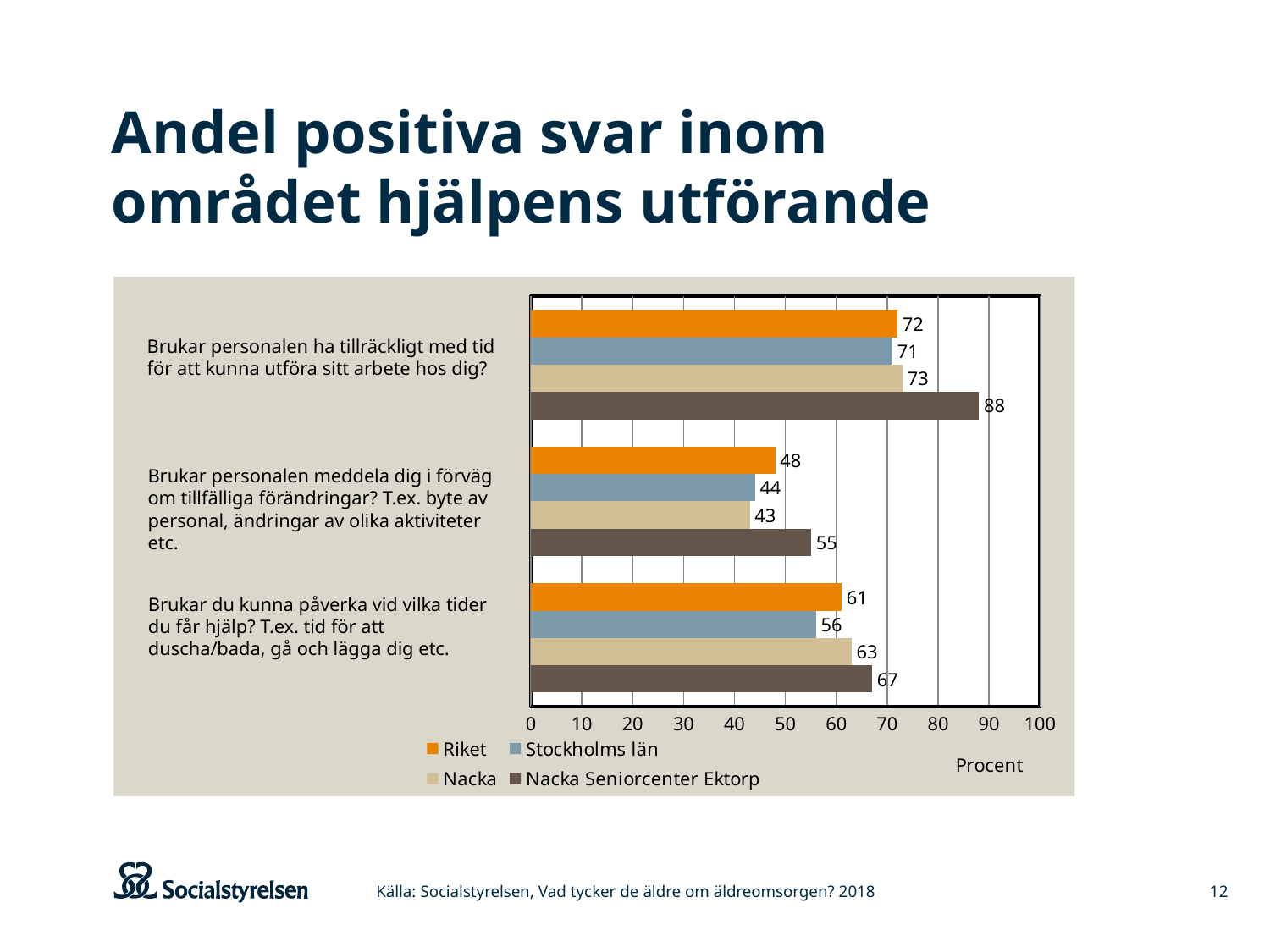
What is the value for Riket for the question 'Brukar personalen meddela dig i förväg om tillfälliga förändringar?' 48 What unit is shown on the horizontal axis of the chart? Procent How many series does the legend list? 4 What is the value for Stockholms län for the question 'Brukar du kunna påverka vid vilka tider du får hjälp?' 56 What is the value for Nacka Seniorcenter Ektorp for the question 'Brukar personalen ha tillräckligt med tid för att kunna utföra sitt arbete hos dig?' 88 What is the difference between Nacka Seniorcenter Ektorp and Riket for the question 'Brukar personalen ha tillräckligt med tid för att kunna utföra sitt arbete hos dig?' 16 How many question categories are plotted on the chart? 3 What type of chart is shown on the slide? Bar chart Which series has the highest value for the question 'Brukar personalen meddela dig i förväg om tillfälliga förändringar?' Nacka Seniorcenter Ektorp For the question 'Brukar du kunna påverka vid vilka tider du får hjälp?', which is larger: Nacka or Riket? Nacka What is the value for Nacka for the question 'Brukar personalen ha tillräckligt med tid för att kunna utföra sitt arbete hos dig?' 73 Which series has the lowest value for the question 'Brukar personalen meddela dig i förväg om tillfälliga förändringar?' Nacka